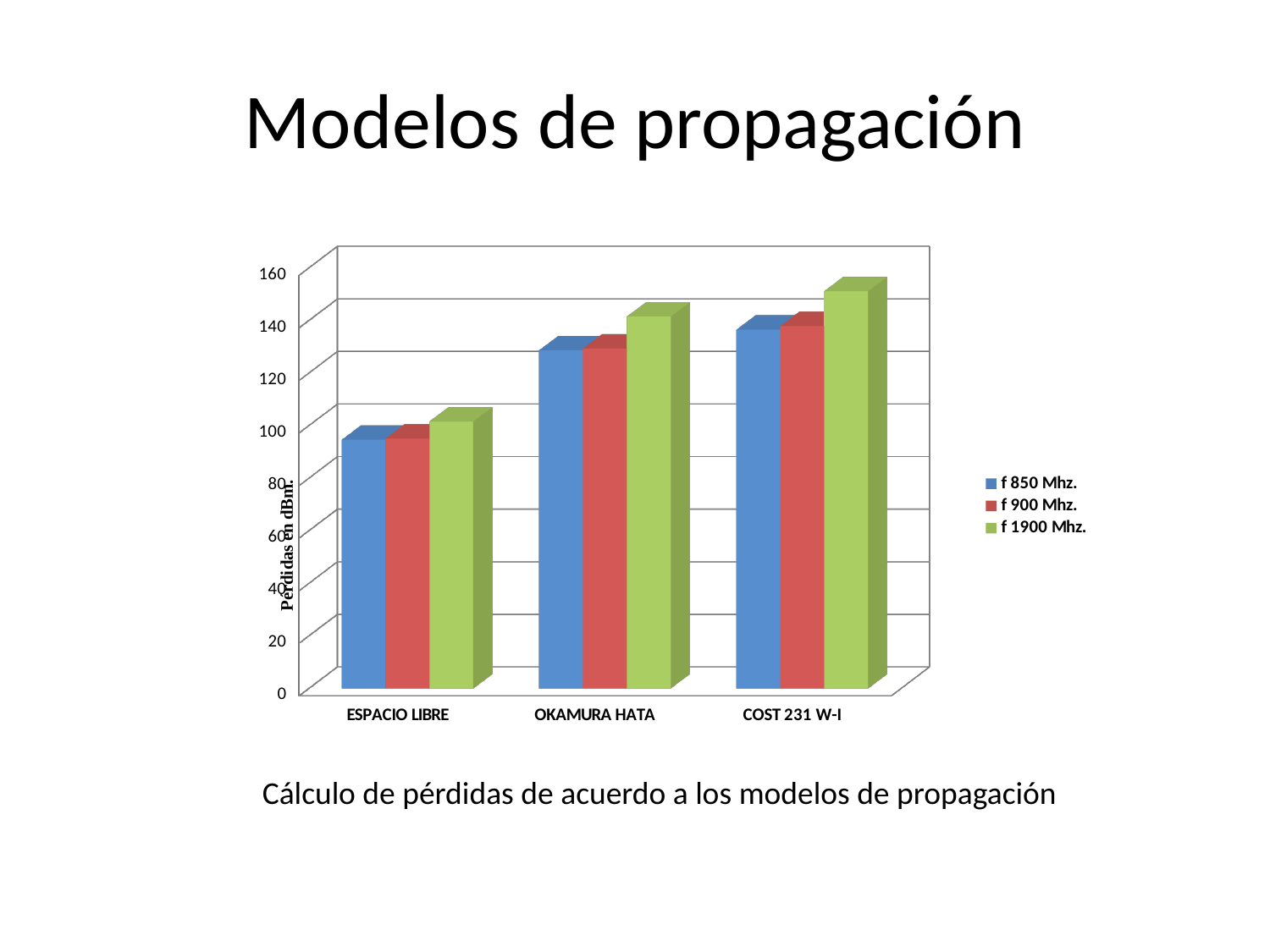
Which category has the highest value for the f 1900 Mhz. series? COST 231 W-I Do the f 1900 Mhz. values rise or fall from ESPACIO LIBRE to COST 231 W-I? rise Which category has the lowest value for the f 850 Mhz. series? ESPACIO LIBRE What kind of chart is shown on the slide? bar chart Is the f 850 Mhz. value for ESPACIO LIBRE greater or less than 100? less How many series does the chart's legend list? 3 For the f 900 Mhz. series, which is larger: OKAMURA HATA or ESPACIO LIBRE? OKAMURA HATA What is the title of the chart's vertical axis? Pérdidas en dBm. For COST 231 W-I, which series has the larger value: f 850 Mhz. or f 1900 Mhz.? f 1900 Mhz. Is the f 1900 Mhz. value for COST 231 W-I greater or less than 140? greater Is the f 850 Mhz. value for OKAMURA HATA greater or less than 120? greater How many categories are shown on the x axis of the chart? 3